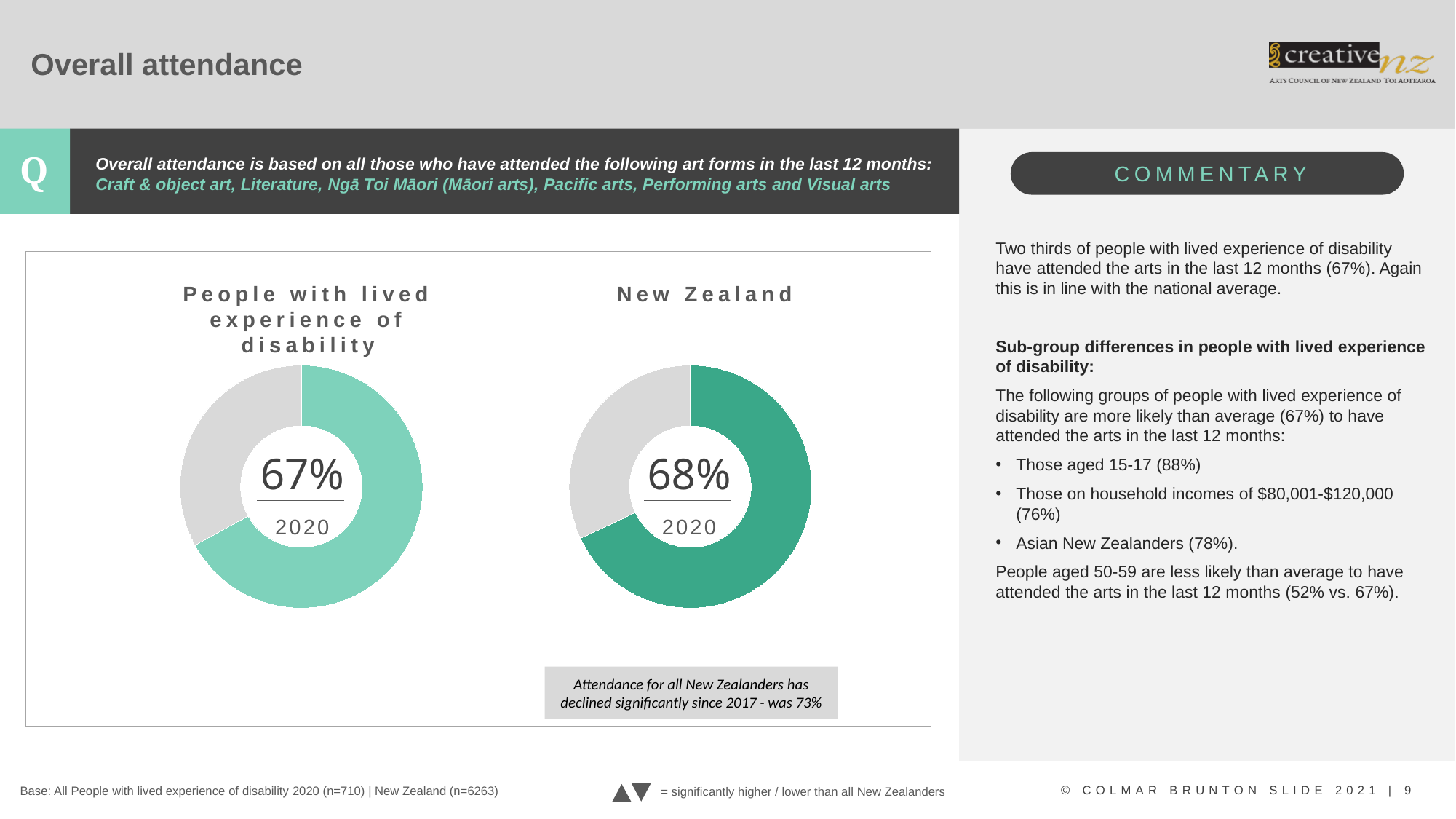
What is the title of the left-hand donut chart? People with lived experience of disability By how many percentage points has attendance for all New Zealanders declined from 2017 (73%) to 2020 (68%)? 5 percentage points How many donut charts are shown on the slide? 2 Is the value in the 'People with lived experience of disability' donut chart greater or less than 50%? greater What is the difference in percentage points between the 'New Zealand' value (68%) and the 'People with lived experience of disability' value (67%)? 1 percentage point According to the note under the 'New Zealand' chart, what was attendance for all New Zealanders in 2017? 73% What year is labelled beneath the percentage in the 'New Zealand' donut chart? 2020 Which chart shows the higher attendance value, 'People with lived experience of disability' or 'New Zealand'? New Zealand What kind of chart is used to show the attendance figures on this slide? Donut (pie) chart In the 'People with lived experience of disability' donut chart, what percentage is shown in the centre? 67% In the 'New Zealand' donut chart, what percentage is shown in the centre? 68% What year is labelled beneath the percentage in the 'People with lived experience of disability' donut chart? 2020